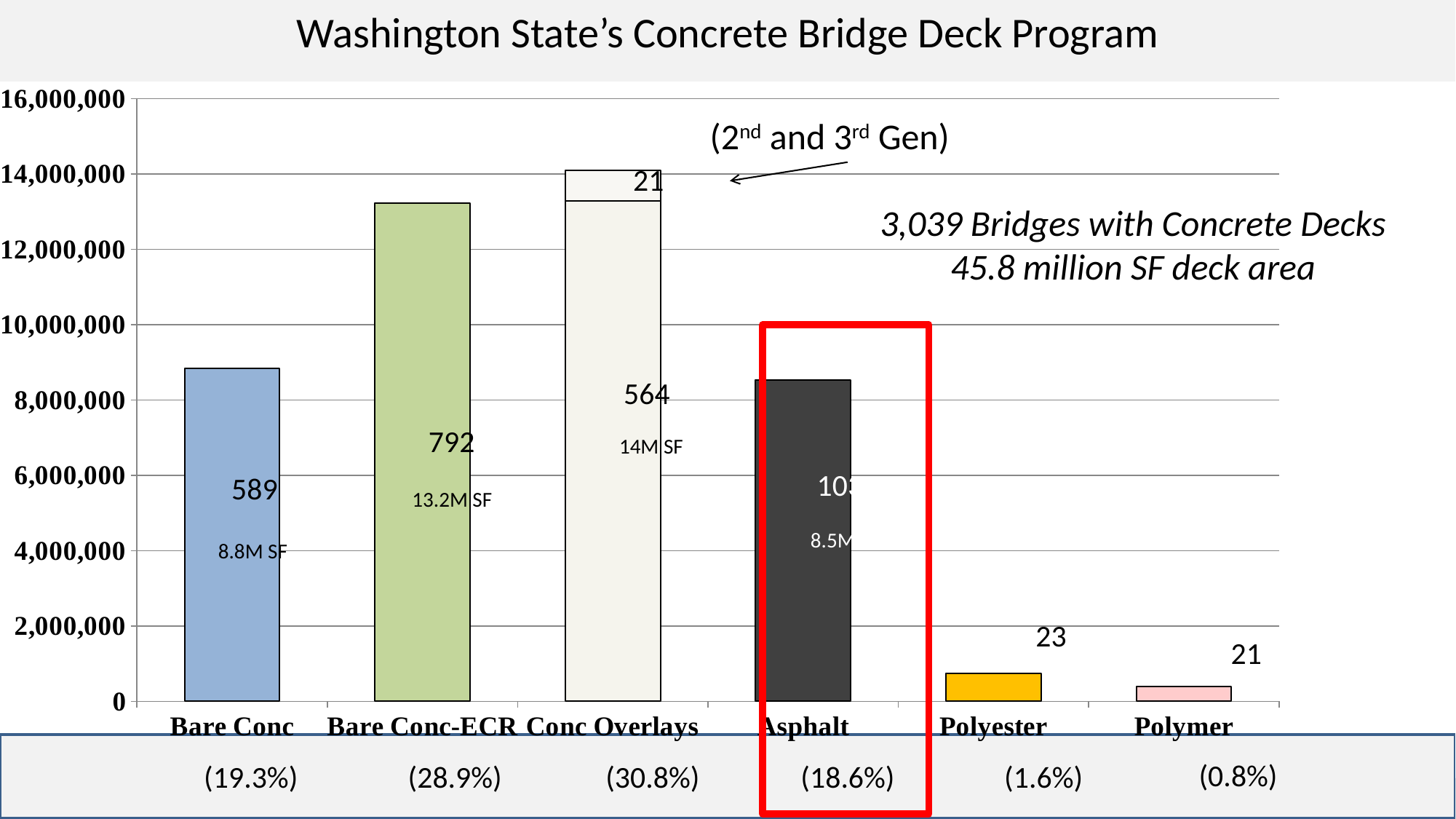
What deck area is labelled on the Bare Conc bar? 8.8M SF Is the value for Polyester greater or less than 2,000,000? less What is the difference between the bridge counts labelled on the Bare Conc-ECR bar (792) and the Bare Conc bar (589)? 203 Which category has the shortest bar in the chart? Polymer Which category has the tallest bar in the chart? Conc Overlays Is the value for Bare Conc-ECR greater or less than 12,000,000? greater What deck area is labelled on the Bare Conc-ECR bar? 13.2M SF What kind of chart is shown on the slide? bar chart What number is labelled above the Polyester bar? 23 How many deck categories are shown along the x axis of the chart? 6 What number of bridges is labelled on the Bare Conc-ECR bar? 792 What percentage is shown below the Asphalt category? 18.6%